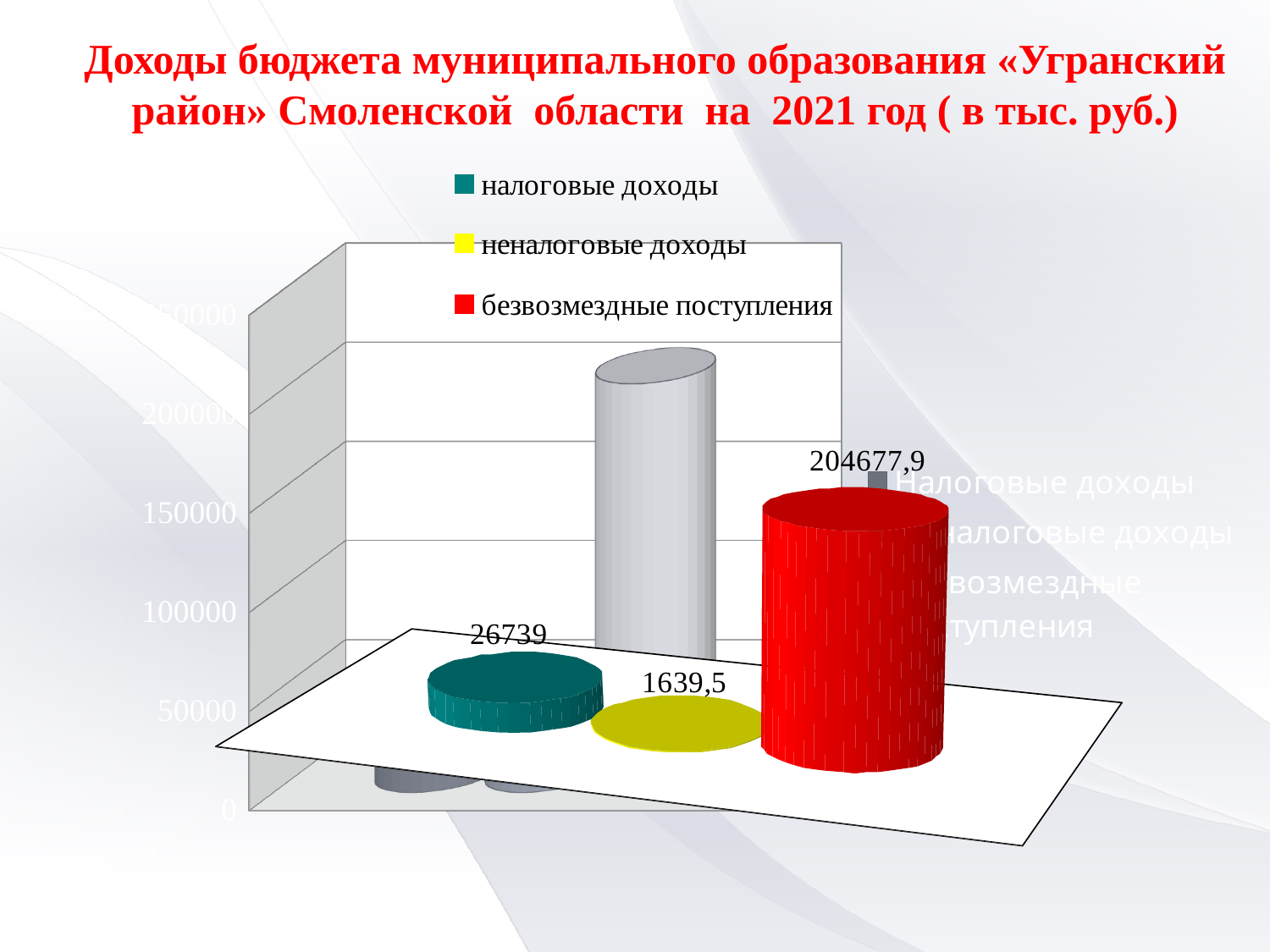
What is the difference between налоговые доходы and неналоговые доходы? 25099,5 What kind of chart is shown on the slide? bar chart Which category has the lowest value? неналоговые доходы How many series does the legend list? 3 Is the value for безвозмездные поступления greater or less than 200000? greater What is the difference between безвозмездные поступления and налоговые доходы? 177938,9 Which category has the highest value? безвозмездные поступления Which is larger, налоговые доходы or неналоговые доходы? налоговые доходы What is the value for неналоговые доходы? 1639,5 What is the value for налоговые доходы? 26739 What is the value for безвозмездные поступления? 204677,9 What colour is the bar for безвозмездные поступления? red